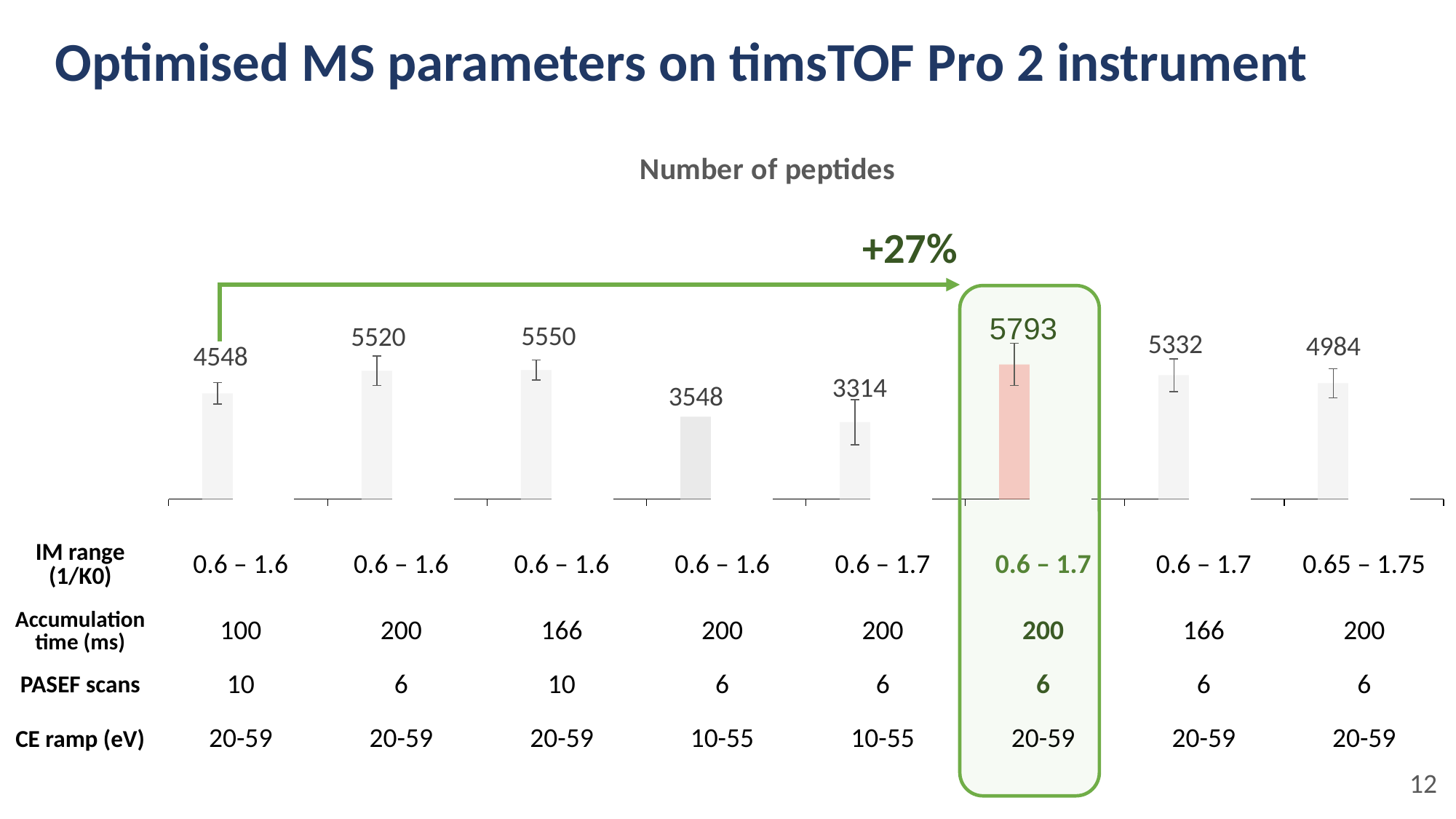
Which has more peptides: the second bar (0.6 – 1.6, 200 ms, 6 scans) or the seventh bar (0.6 – 1.7, 166 ms, 6 scans)? the second bar (5520) What is the number of peptides for the first bar (IM range 0.6 – 1.6, accumulation time 100 ms, 10 PASEF scans)? 4548 Which bar has the highest number of peptides? the highlighted bar (0.6 – 1.7, 200 ms, 6 PASEF scans, CE ramp 20-59) with 5793 What is the number of peptides for the last bar (IM range 0.65 – 1.75)? 4984 What kind of chart is shown on the slide? bar chart What is the difference in number of peptides between the highlighted bar (5793) and the first bar (4548)? 1245 What is the lowest number of peptides shown in the chart? 3314 What percentage improvement is indicated by the green arrow? +27% How many bars are plotted in the Number of peptides chart? 8 What is the title of the chart? Number of peptides What is the number of peptides for the highlighted (green-boxed) condition? 5793 What is the difference in number of peptides between the third bar (5550) and the fourth bar (3548)? 2002